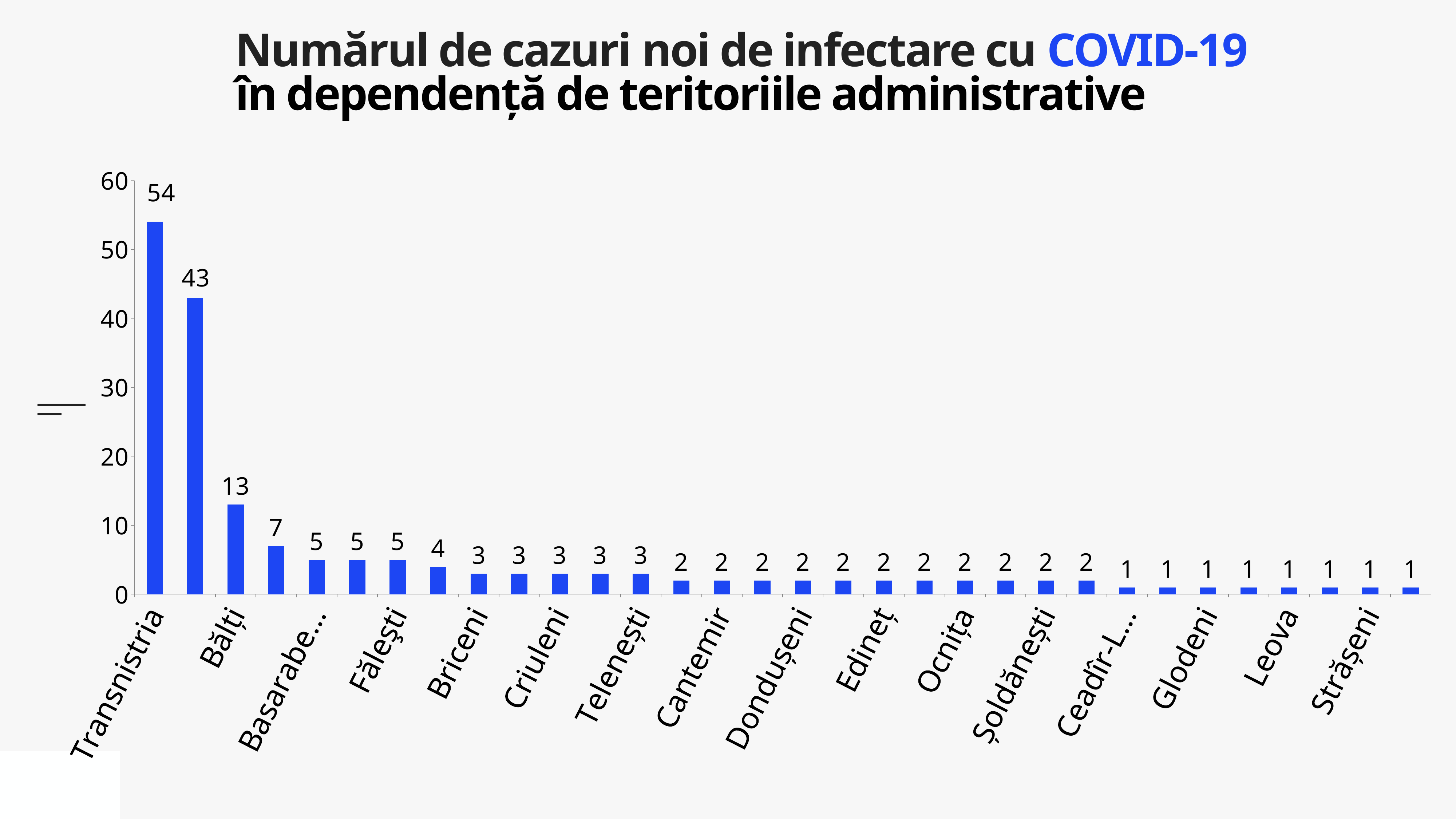
What kind of chart is shown on the slide? bar chart What is the number of new COVID-19 cases for Transnistria? 54 What is the number of new COVID-19 cases for Bălți? 13 How many bars are plotted in the chart? 32 Do the values rise or fall from left to right along the x axis? fall Is the value for Transnistria greater or less than 50? greater Which territory has the highest number of new cases? Transnistria What is the value shown for Fălești? 5 What is the value shown for Briceni? 3 What is the value shown for Glodeni? 1 Which has a larger value, Bălți or Briceni? Bălți What is the difference between the values for Transnistria and Bălți? 41